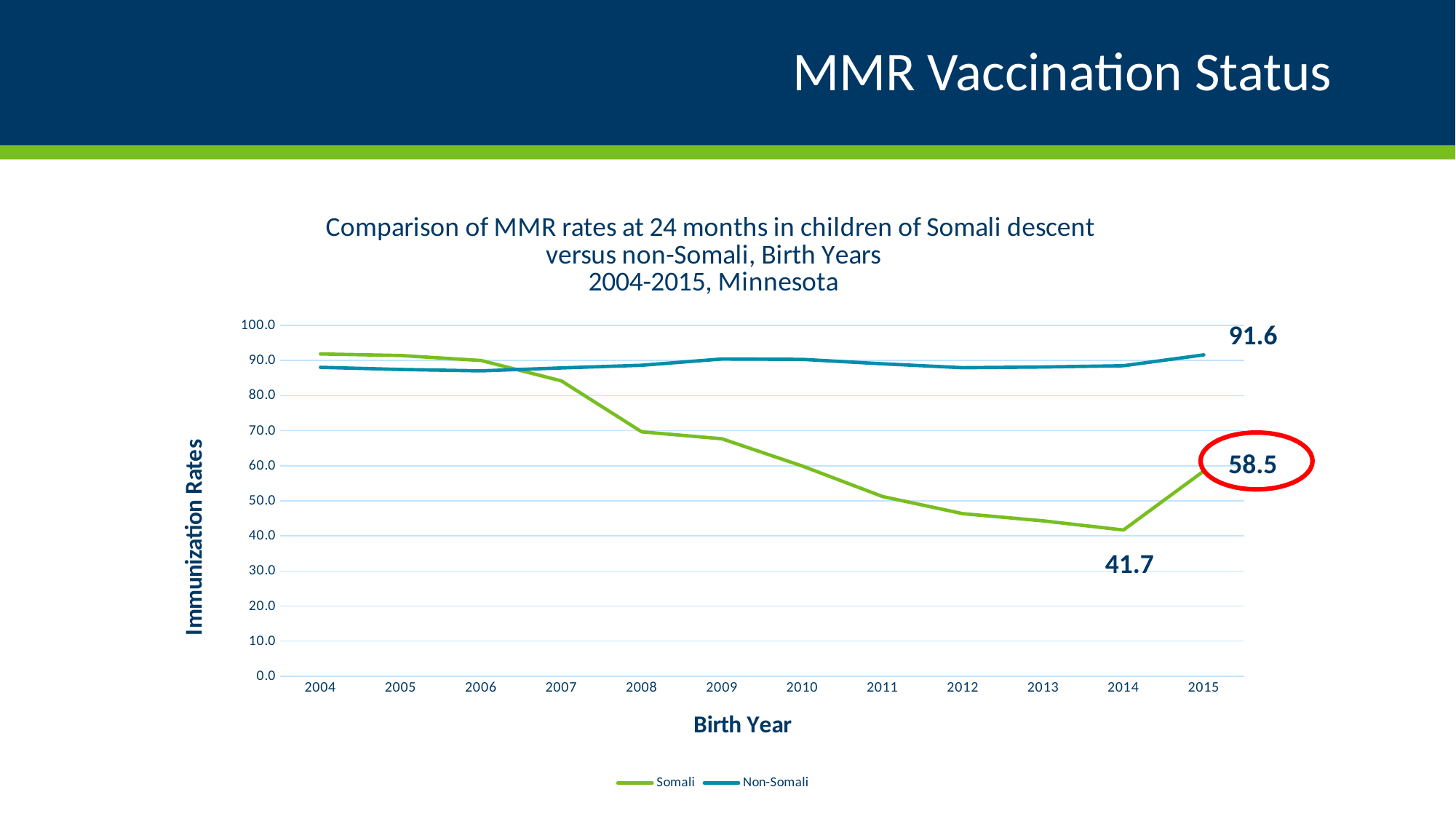
Is the Somali immunization rate for birth year 2012 greater or less than 50.0? less What is the difference between the Non-Somali and Somali immunization rates for birth year 2015? 33.1 In which birth year is the Somali immunization rate lowest? 2014 What is the Non-Somali immunization rate for birth year 2015? 91.6 What kind of chart is shown on the slide? Line chart For birth year 2010, which series has the higher immunization rate, Somali or Non-Somali? Non-Somali Does the Somali immunization rate rise or fall from birth year 2004 to 2014? Fall How many series does the legend list? 2 By how much did the Somali immunization rate increase from birth year 2014 to 2015? 16.8 What is the Somali immunization rate for birth year 2015? 58.5 How many birth years are plotted on the x axis? 12 What is the Somali immunization rate for birth year 2014? 41.7